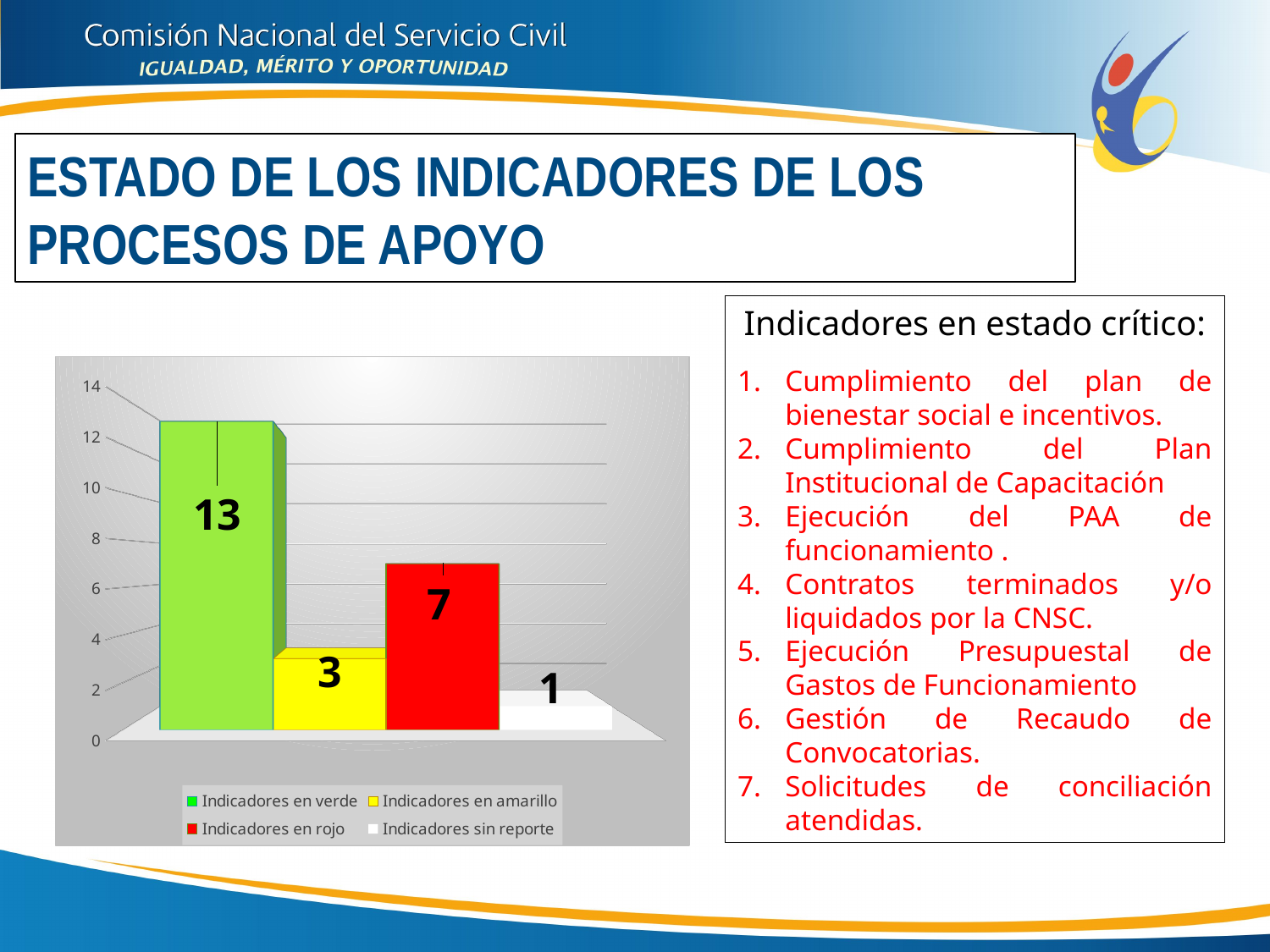
Which is larger, Indicadores en rojo or Indicadores en amarillo? Indicadores en rojo What is the value for Indicadores en verde? 13 What is the difference between Indicadores en verde and Indicadores en rojo? 6 What is the value for Indicadores en rojo? 7 How many series does the legend list? 4 Which series has the lowest value? Indicadores sin reporte What colour is the bar for Indicadores en rojo? red What is the value for Indicadores en amarillo? 3 What kind of chart is shown on the slide? bar chart What is the value for Indicadores sin reporte? 1 Which series has the highest value? Indicadores en verde Is the value for Indicadores en verde greater or less than 10? greater